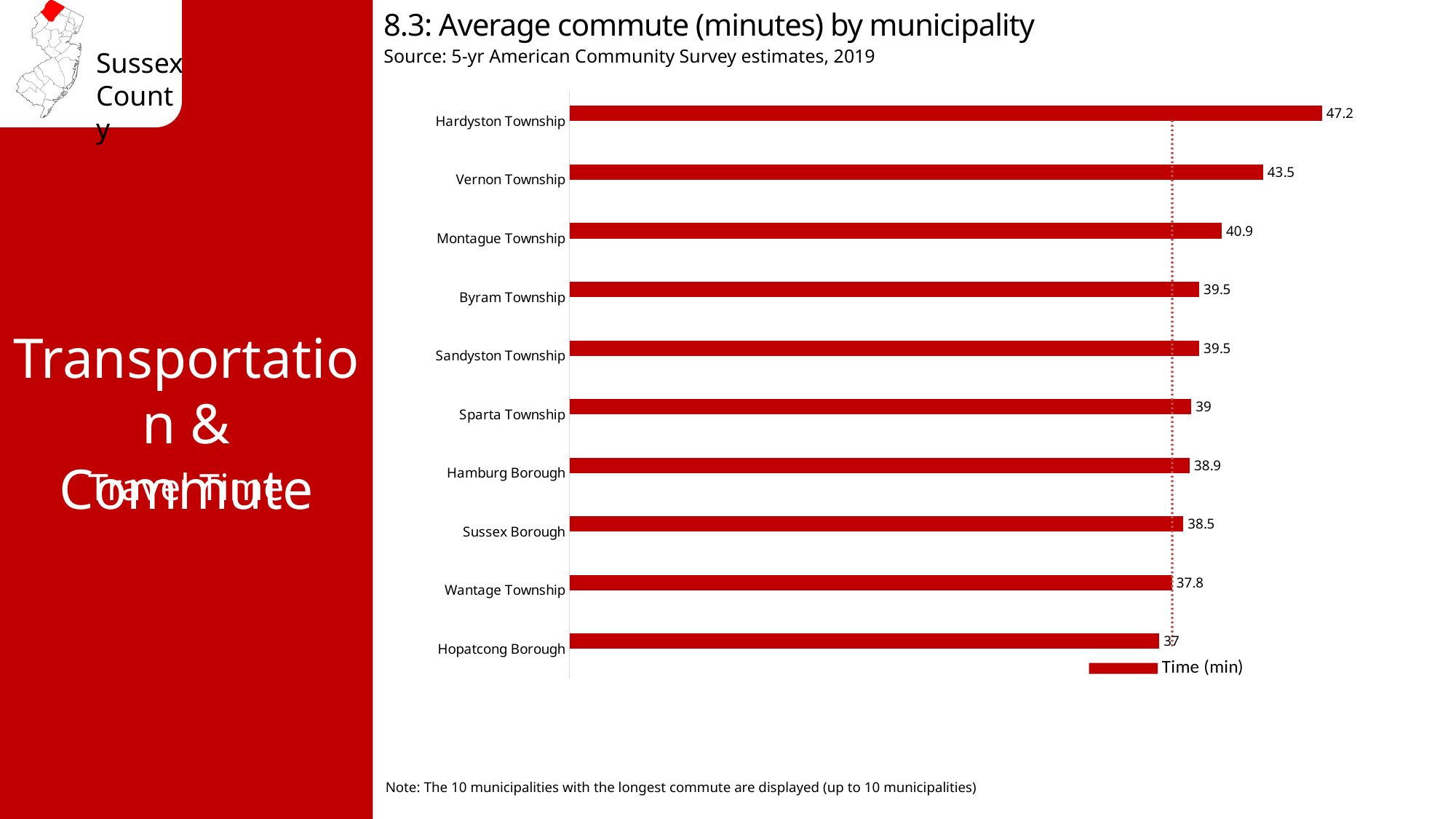
What is the average commute time for Hardyston Township? 47.2 How many municipalities are shown in the chart? 10 What is the difference in average commute time between Montague Township and Hopatcong Borough? 3.9 Which municipality has the longest average commute? Hardyston Township Which has a longer average commute, Sparta Township or Sussex Borough? Sparta Township Which municipality shown has the shortest average commute? Hopatcong Borough What is the average commute time for Vernon Township? 43.5 What is the average commute time for Wantage Township? 37.8 What is the series name shown in the chart legend? Time (min) What is the difference in average commute time between Hardyston Township and Vernon Township? 3.7 What kind of chart is shown on the slide? Bar chart What is the average commute time for Hamburg Borough? 38.9